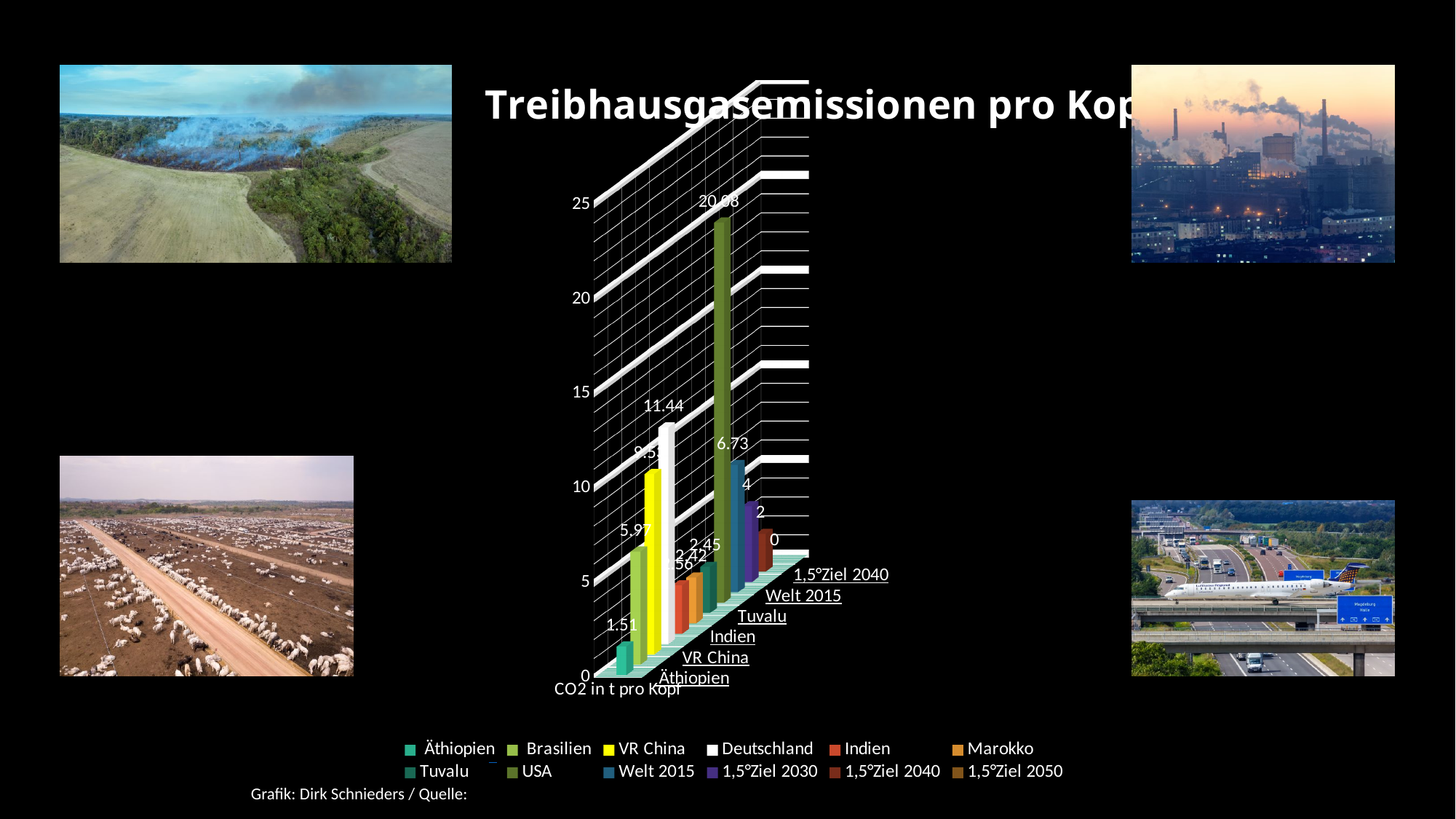
How many series does the legend list? 12 What is the value for Äthiopien? 1.51 What is the value for Brasilien? 5.97 What is the value for Welt 2015? 6.73 What is the axis label shown at the bottom of the chart? CO2 in t pro Kopf What is the value for Deutschland? 11.44 Which category has the highest value? USA What is the value for 1,5°Ziel 2030? 4 Which is larger, the value for Welt 2015 or the value for Brasilien? Welt 2015 What is the difference between the values for Deutschland and Brasilien? 5.47 What kind of chart is shown on the slide? bar chart Which category has the lowest value? 1,5°Ziel 2050